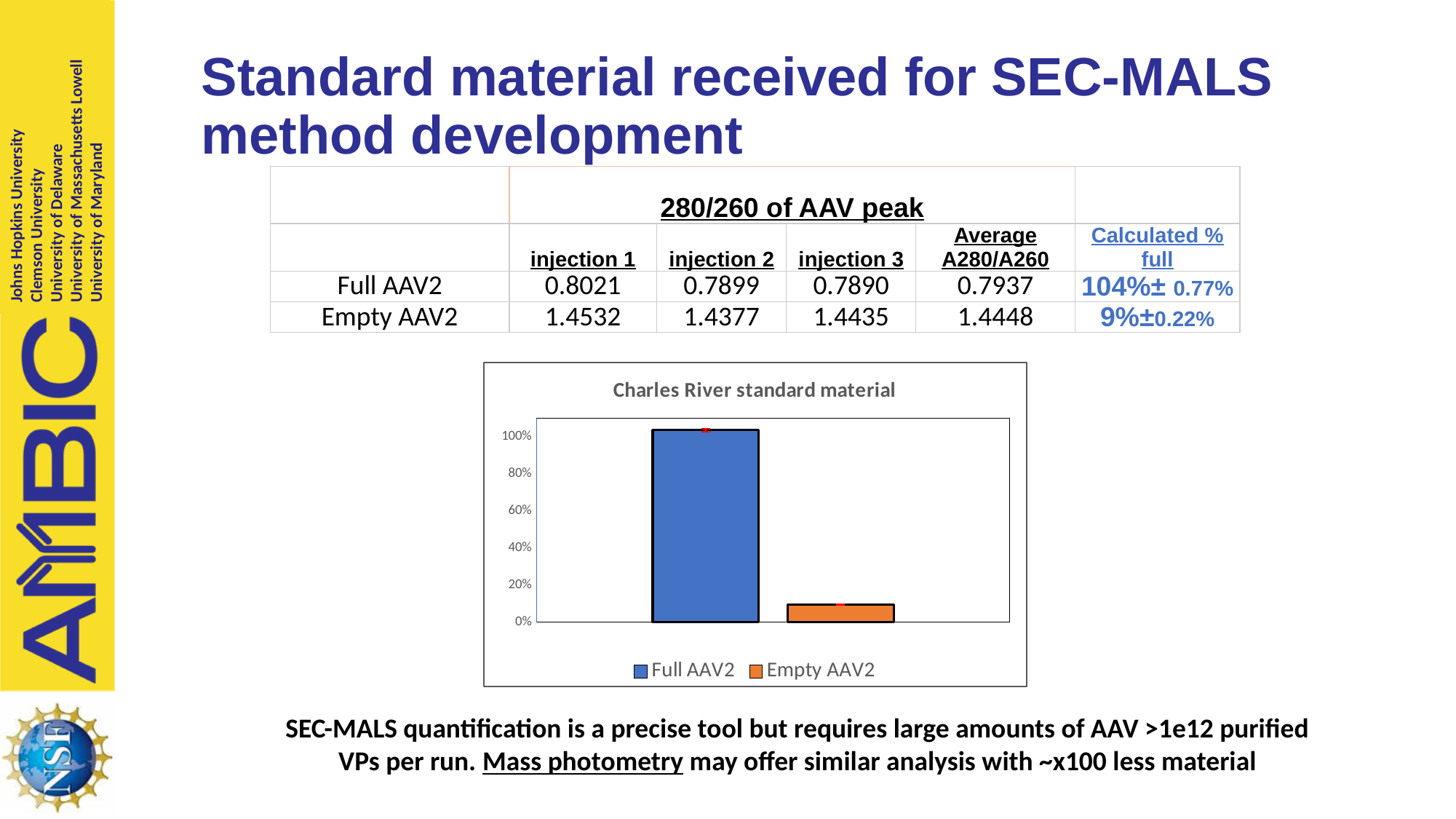
How many series does the chart legend list? 2 Which series has the lowest bar in the chart? Empty AAV2 Is the bar for Full AAV2 greater or less than 100%? greater What is the highest value shown on the chart's y axis? 100% Which series has the highest bar in the chart? Full AAV2 Is the bar for Empty AAV2 greater or less than 20%? less What is the title of the chart on the slide? Charles River standard material What kind of chart is shown on the slide? bar chart Which is larger in the chart, Full AAV2 or Empty AAV2? Full AAV2 Is the bar for Full AAV2 greater or less than 80%? greater How many bars are plotted in the chart? 2 What colour is the Empty AAV2 bar in the chart? orange